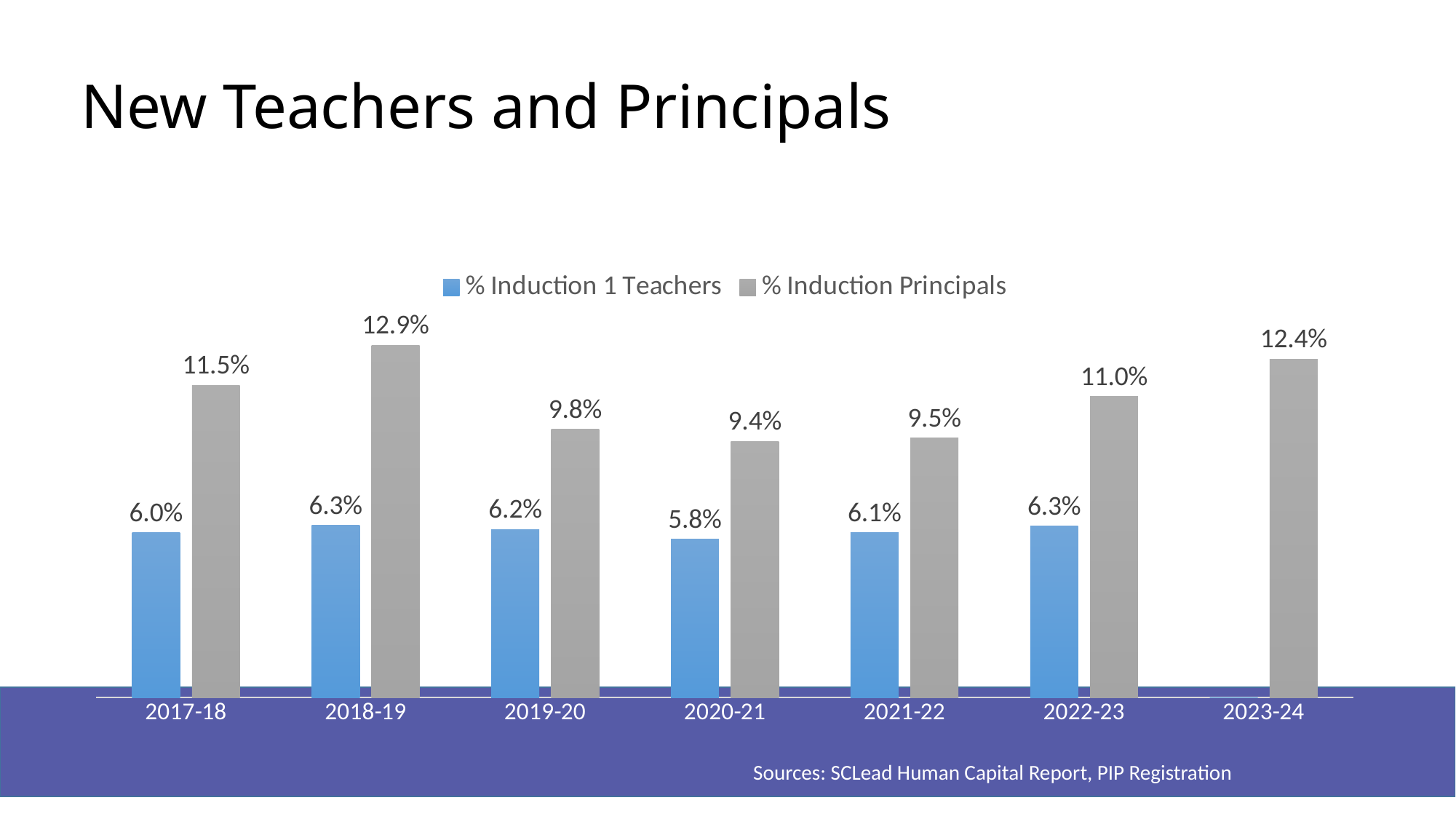
What is the % Induction 1 Teachers value for 2020-21? 5.8% How many series does the legend list? 2 In which year is the % Induction Principals value highest? 2018-19 What is the % Induction Principals value for 2018-19? 12.9% What is the % Induction 1 Teachers value for 2017-18? 6.0% What is the % Induction Principals value for 2023-24? 12.4% How many school years are shown on the x axis? 7 What kind of chart is shown on the slide? Bar chart Which is larger: the % Induction Principals value for 2017-18 or for 2022-23? 2017-18 In which year is the % Induction Principals value lowest? 2020-21 What is the difference between the % Induction Principals and % Induction 1 Teachers values in 2018-19? 6.6 percentage points Does the % Induction Principals value rise or fall from 2018-19 to 2020-21? Fall